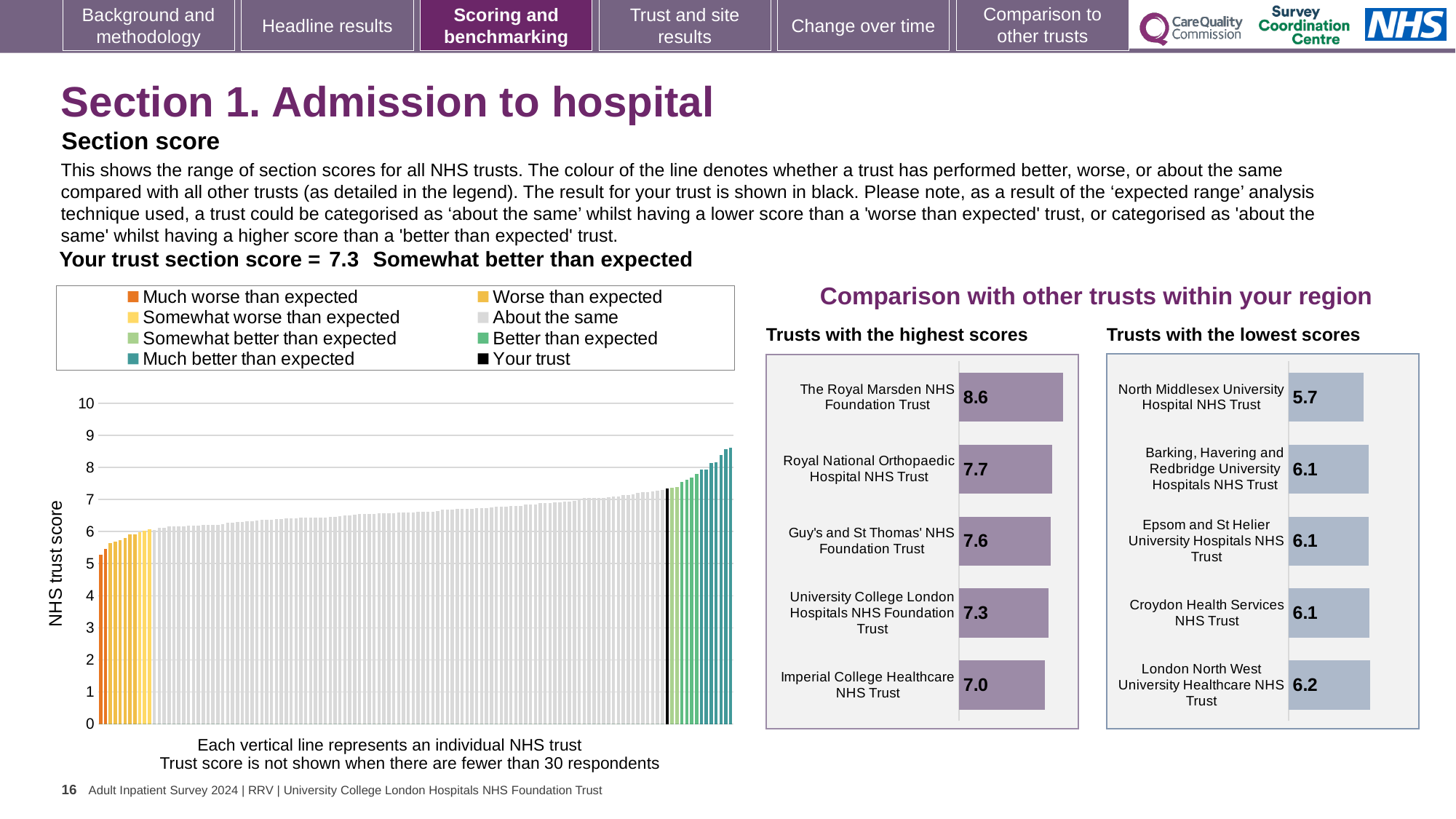
What kind of chart is the large chart on the left showing NHS trust scores? Bar chart In the 'Trusts with the highest scores' chart, what is the score for The Royal Marsden NHS Foundation Trust? 8.6 In the large chart on the left, is the value of the tallest bar greater or less than 8? greater How many trusts are shown in the 'Trusts with the lowest scores' chart? 5 In the 'Trusts with the highest scores' chart, which trust has the highest score? The Royal Marsden NHS Foundation Trust In the 'Trusts with the highest scores' chart, which has the higher score: Royal National Orthopaedic Hospital NHS Trust or Guy's and St Thomas' NHS Foundation Trust? Royal National Orthopaedic Hospital NHS Trust In the 'Trusts with the lowest scores' chart, what is the score for London North West University Healthcare NHS Trust? 6.2 In the 'Trusts with the lowest scores' chart, which trust has the lowest score? North Middlesex University Hospital NHS Trust In the large chart on the left, do the NHS trust scores rise or fall from left to right? Rise In the 'Trusts with the highest scores' chart, what is the score for Imperial College Healthcare NHS Trust? 7.0 How many entries does the legend above the large chart on the left list? 8 In the 'Trusts with the highest scores' chart, what is the difference between the scores of The Royal Marsden NHS Foundation Trust and Imperial College Healthcare NHS Trust? 1.6